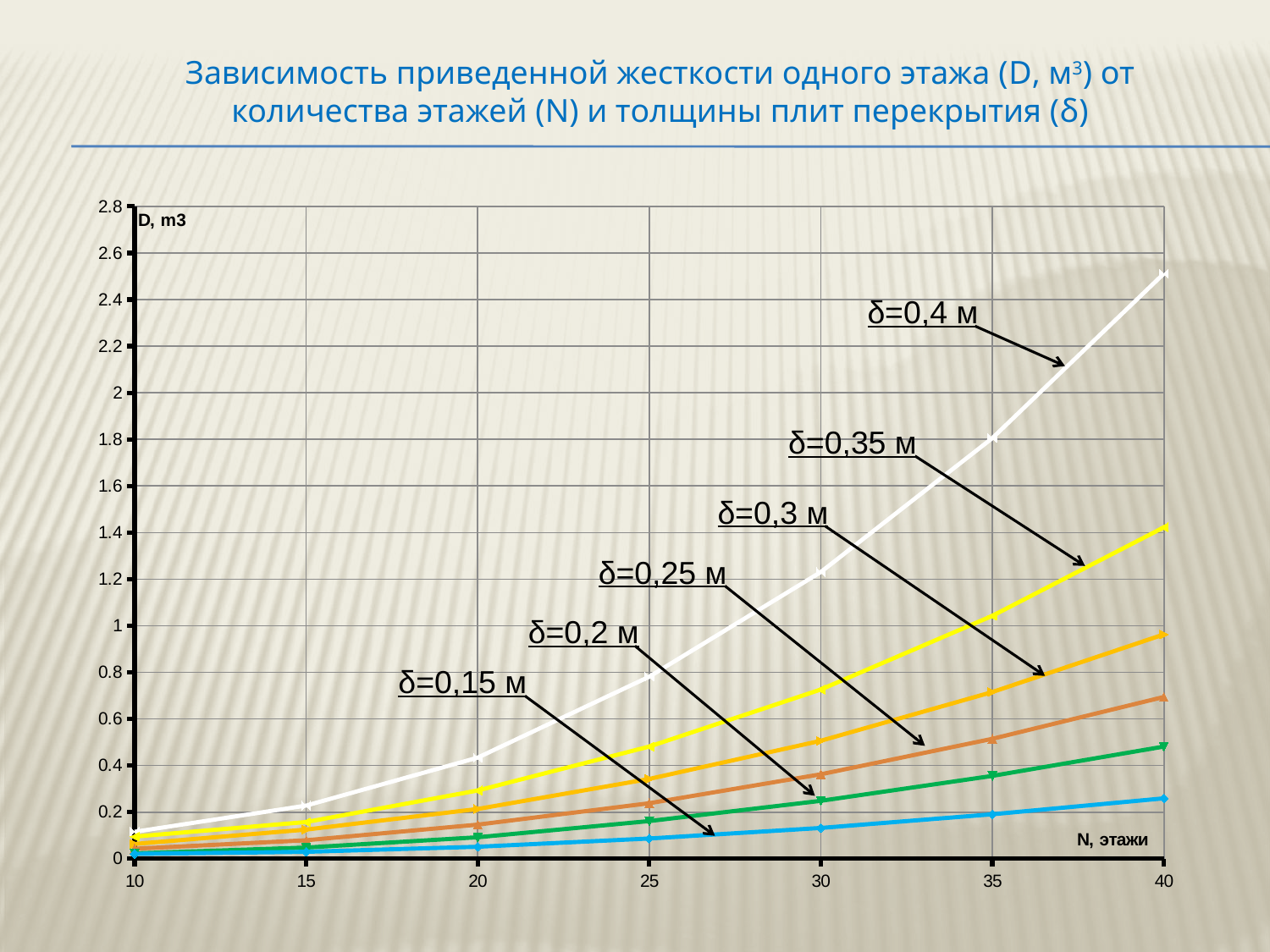
At N=40, which curve has the larger value of D: δ=0,4 м or δ=0,15 м? δ=0,4 м Do the values of D rise or fall as N increases along the x axis? rise Is the value of D for δ=0,2 м at N=40 greater or less than 0.6? less What kind of chart is shown on the slide? line chart How many curves (values of δ) are labelled on the chart? 6 What is the label of the y axis? D, m3 Which curve has the lowest values of D across the chart? δ=0,15 м Is the value of D for δ=0,35 м at N=40 greater or less than 1.2? greater How many values of N are marked on the x axis? 7 What is the label of the x axis? N, этажи Which curve reaches the highest value of D at N=40? δ=0,4 м Is the value of D for δ=0,4 м at N=40 greater or less than 2? greater